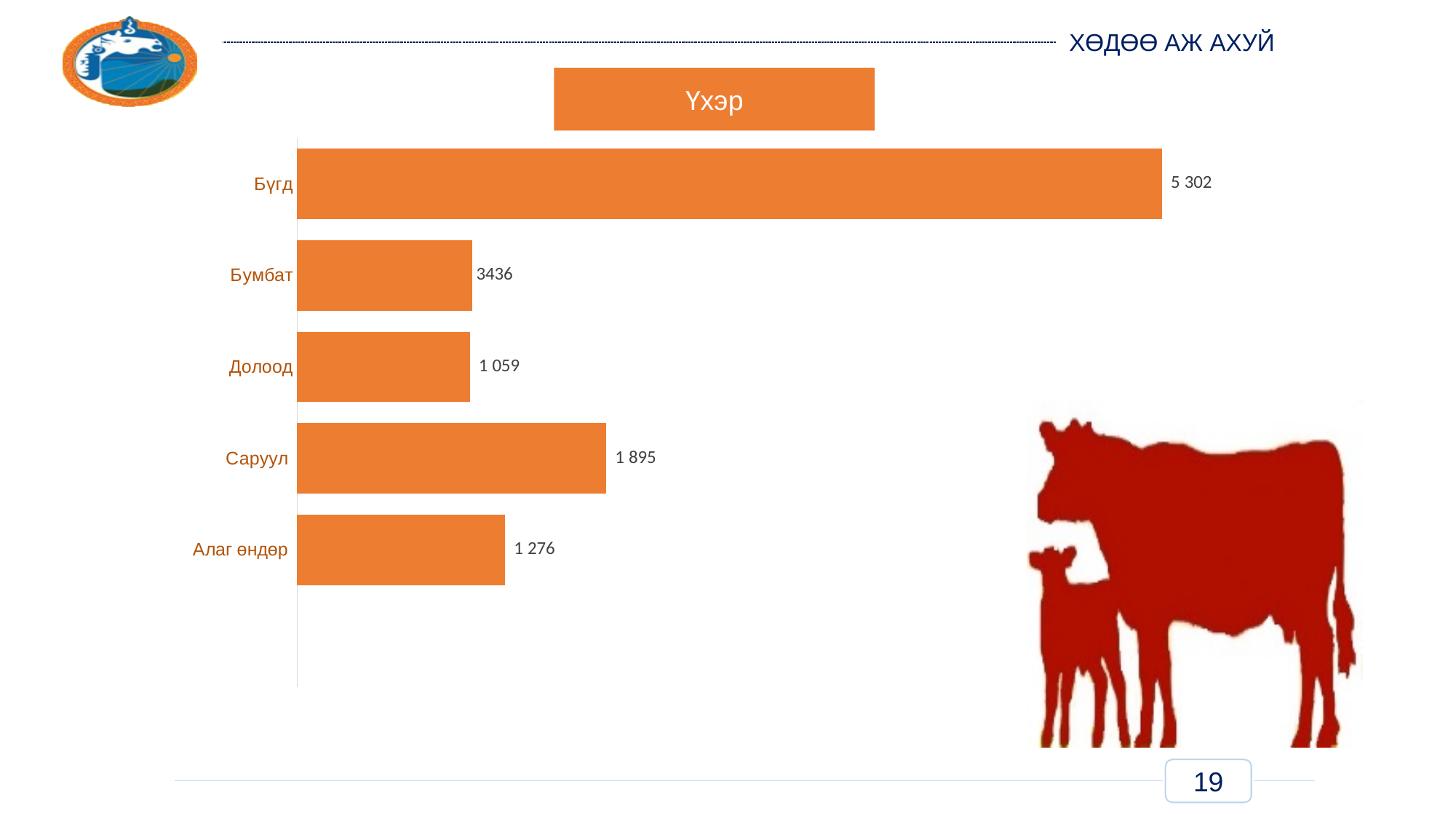
What is the value shown for Долоод? 1 059 What is the value shown for Алаг өндөр? 1 276 What is the value for Бүгд in the Үхэр chart? 5 302 Which category has the highest value in the chart? Бүгд What is the difference between the values for Саруул and Алаг өндөр? 619 What value is labelled for Саруул? 1 895 What is the difference between the values for Алаг өндөр and Долоод? 217 Which is larger, the value for Саруул or the value for Долоод? Саруул How many categories are shown in the chart? 5 What is the title of the chart? Үхэр What kind of chart is shown on the slide? Bar chart What value is printed next to the Бумбат bar? 3436